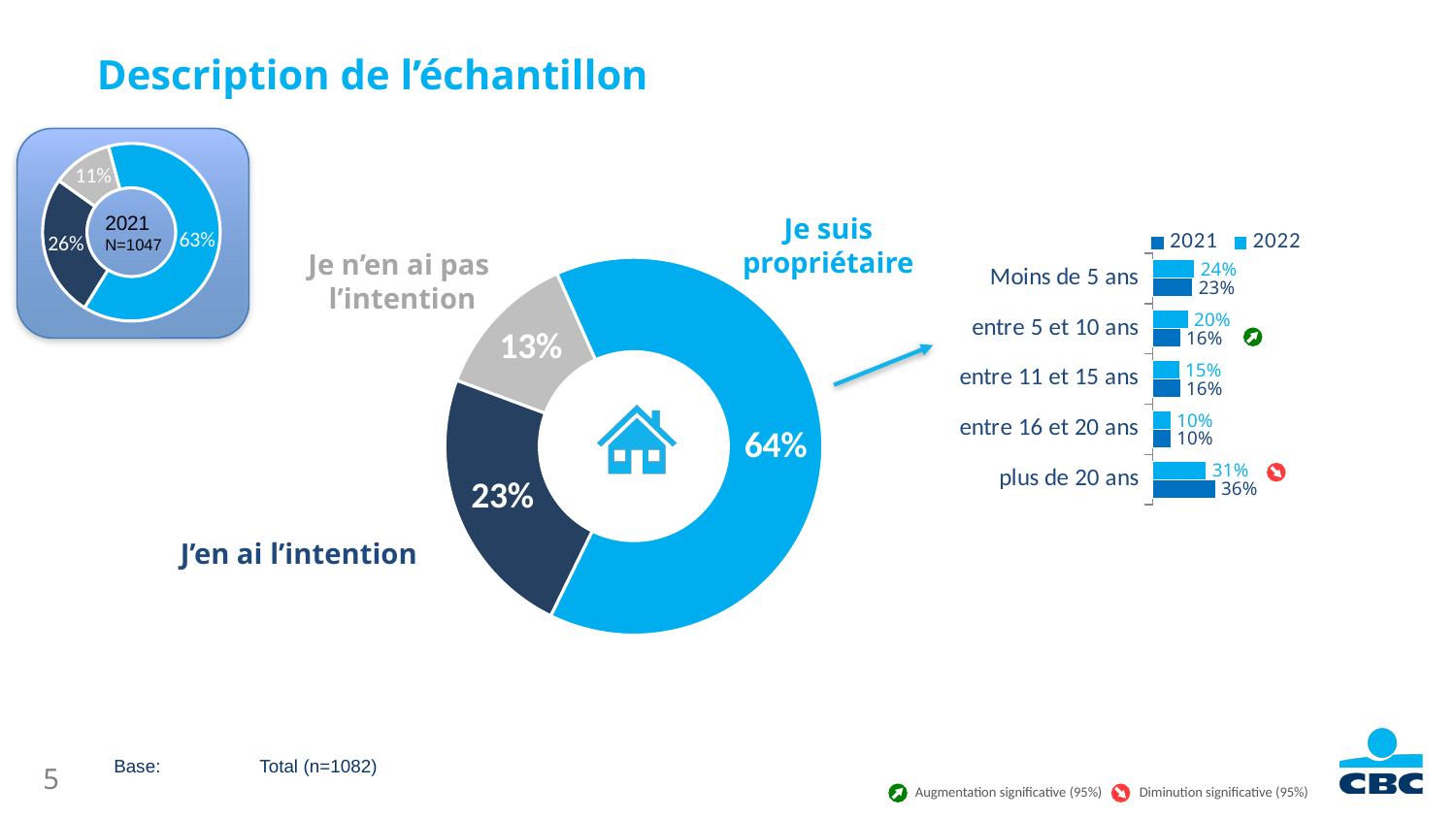
What kind of chart is shown on the right of the slide? bar chart In the bar chart on the right of the slide, which category has the highest 2021 value? plus de 20 ans How many series does the legend of the bar chart on the right of the slide list? 2 In the large donut chart in the centre of the slide, which category has the smallest share? Je n'en ai pas l'intention In the large donut chart in the centre of the slide, what share is labelled "J'en ai l'intention"? 23% What sample size is printed in the centre of the small donut chart at the top left of the slide? N=1047 How many categories does the large donut chart in the centre of the slide show? 3 In the bar chart on the right of the slide, what is the 2022 value for "plus de 20 ans"? 31% In the bar chart on the right of the slide, what is the 2021 value for "entre 5 et 10 ans"? 16% In the large donut chart in the centre of the slide, what share is labelled "Je suis propriétaire"? 64% In the large donut chart in the centre of the slide, what is the difference between the "Je suis propriétaire" share and the "J'en ai l'intention" share? 41 percentage points In the small donut chart at the top left of the slide, what is the largest share shown? 63%